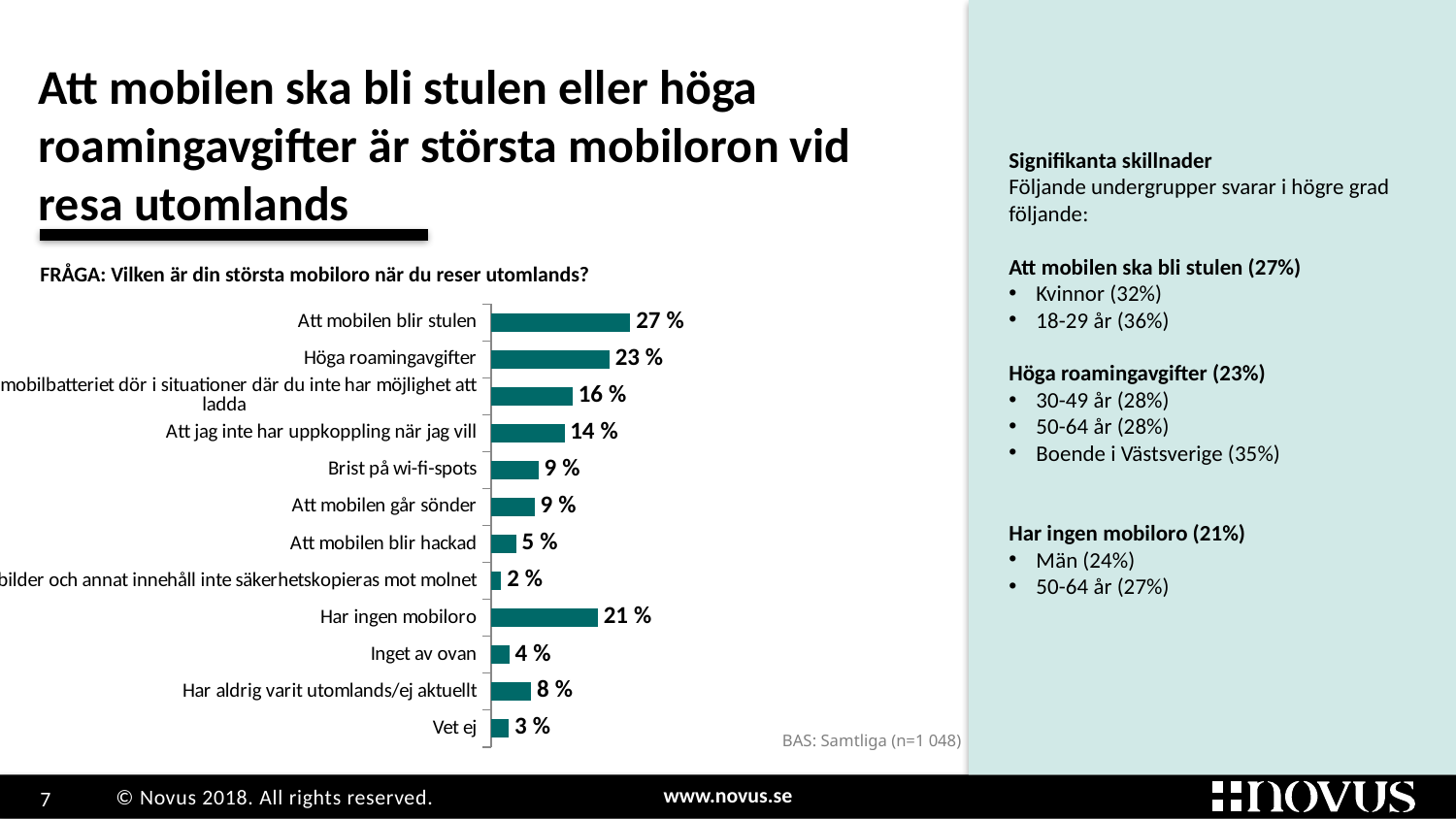
What is the sample size (BAS) stated below the chart? n=1 048 What is the value for "Har aldrig varit utomlands/ej aktuellt"? 8 % What is the value for "Höga roamingavgifter"? 23 % What kind of chart is shown on the slide? Bar chart What percentage of respondents answered "Att mobilen blir stulen"? 27 % Which is larger, "Att jag inte har uppkoppling när jag vill" or "Att mobilen blir hackad"? Att jag inte har uppkoppling när jag vill What is the difference between "Att mobilen blir stulen" and "Höga roamingavgifter"? 4 % What is the value for "Har ingen mobiloro"? 21 % Which category has the highest value in the chart? Att mobilen blir stulen What is the lowest value shown in the chart? 2 % What is the difference between "Har ingen mobiloro" and "Inget av ovan"? 17 % How many categories are shown in the chart? 12